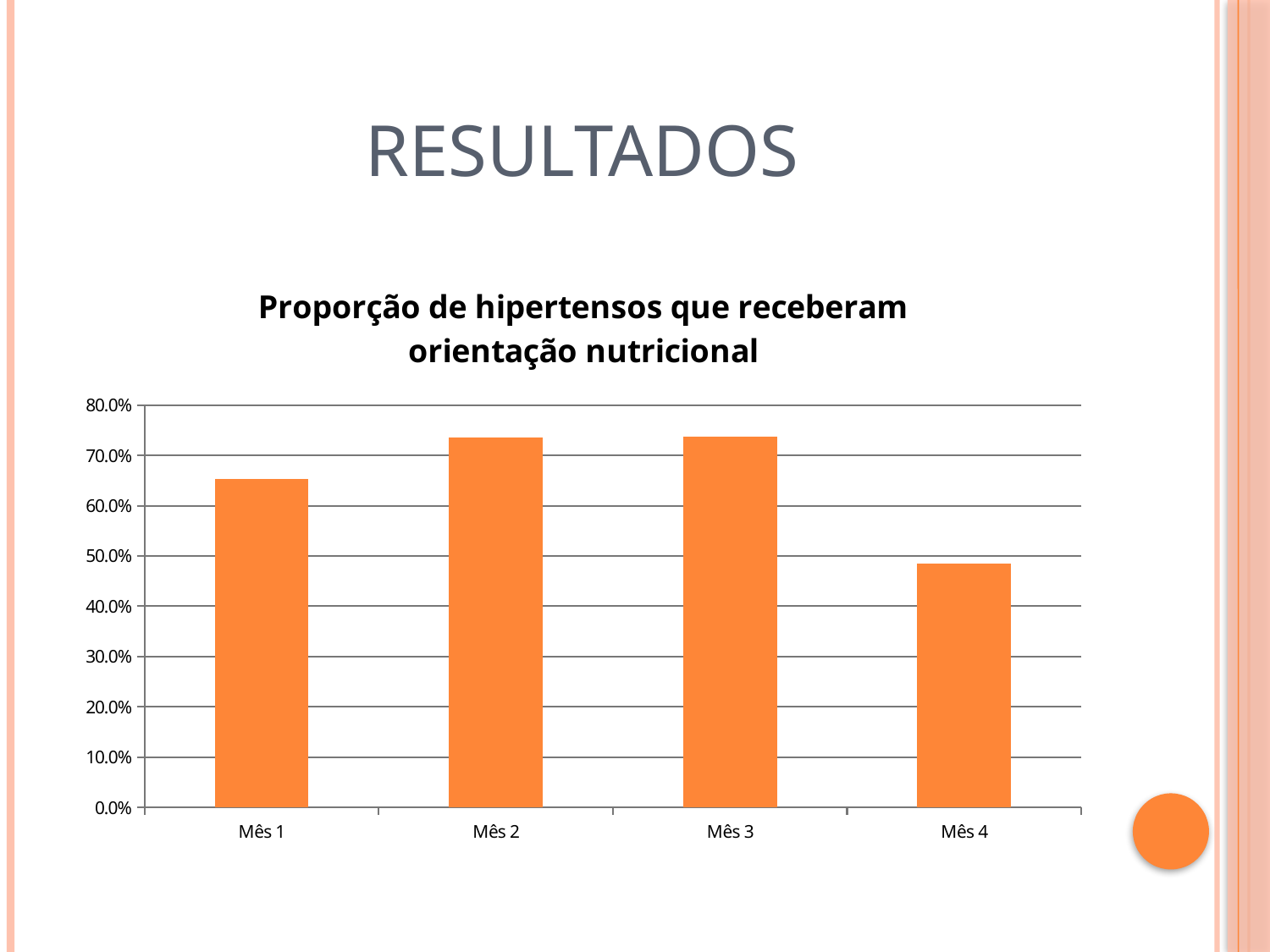
Is the value for Mês 3 greater or less than 70.0%? greater Which is larger, the value for Mês 3 or the value for Mês 4? Mês 3 How many categories (months) are shown on the x axis of the chart? 4 Which is larger, the value for Mês 1 or the value for Mês 2? Mês 2 What type of chart is shown on the slide? Bar chart What colour are the bars in the chart? Orange Which month has the lowest proportion in the chart? Mês 4 Is the value for Mês 2 greater or less than 70.0%? greater Is the value for Mês 4 greater or less than 40.0%? greater What is the title of the chart? Proporção de hipertensos que receberam orientação nutricional